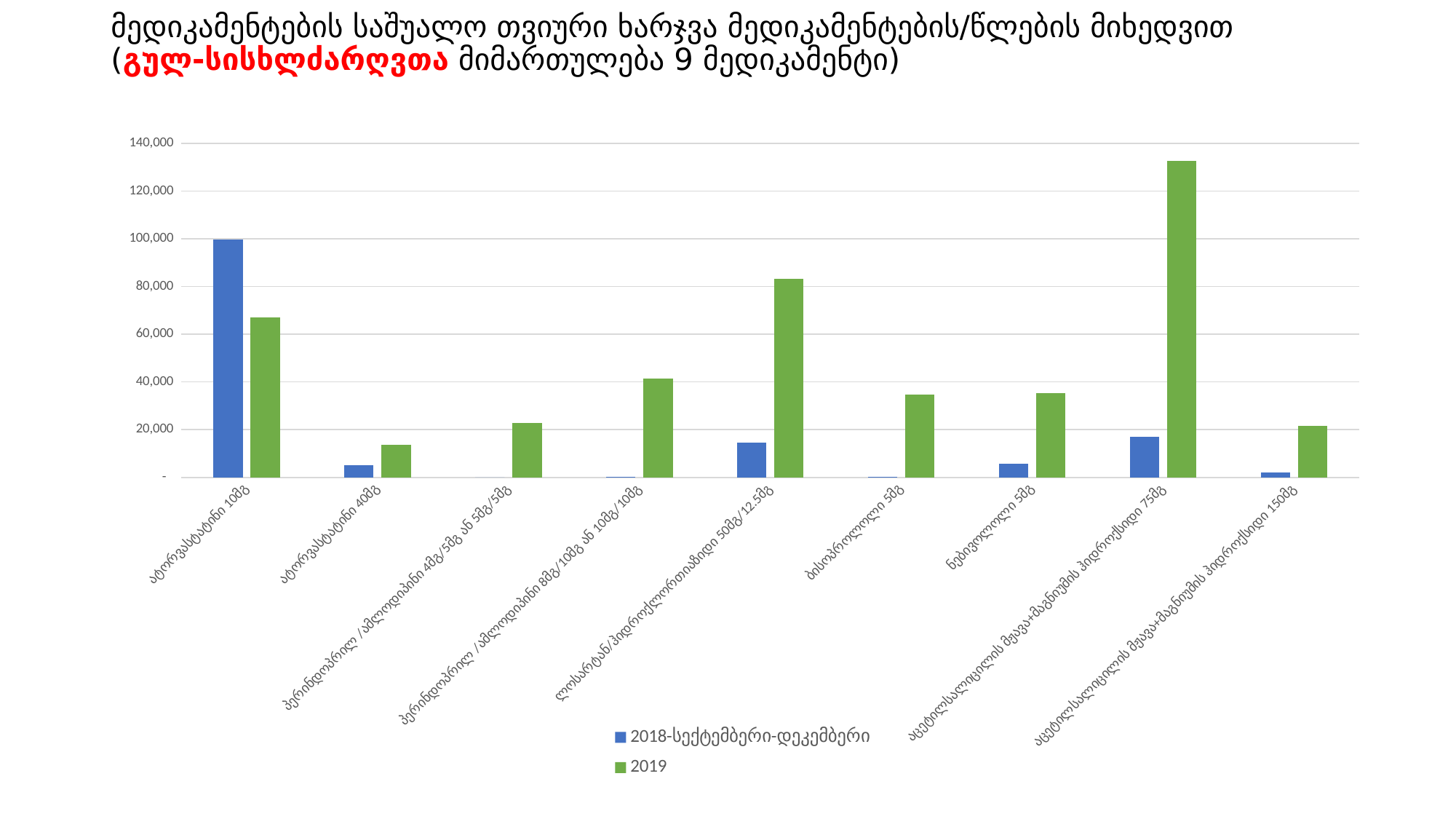
Which category has the highest value in the 2018-სექტემბერი-დეკემბერი series? ატორვასტატინი 10მგ Is the 2019 value for აცეტილსალიცილის მჟავა+მაგნიუმის ჰიდროქსიდი 75მგ greater or less than 120,000? greater Is the 2019 value for ატორვასტატინი 10მგ greater or less than 80,000? less What kind of chart is shown on the slide? bar chart How many medication categories are shown on the x axis? 9 For ბისოპროლოლი 5მგ, which series has the larger value: 2018-სექტემბერი-დეკემბერი or 2019? 2019 Which colour represents the 2019 series in the chart? green How many series does the legend list? 2 For ატორვასტატინი 10მგ, which series has the larger value: 2018-სექტემბერი-დეკემბერი or 2019? 2018-სექტემბერი-დეკემბერი Is the 2019 value for ლოსარტან/ჰიდროქლორთიაზიდი 50მგ/12.5მგ greater or less than 60,000? greater Which category has the highest value in the 2019 series? აცეტილსალიცილის მჟავა+მაგნიუმის ჰიდროქსიდი 75მგ